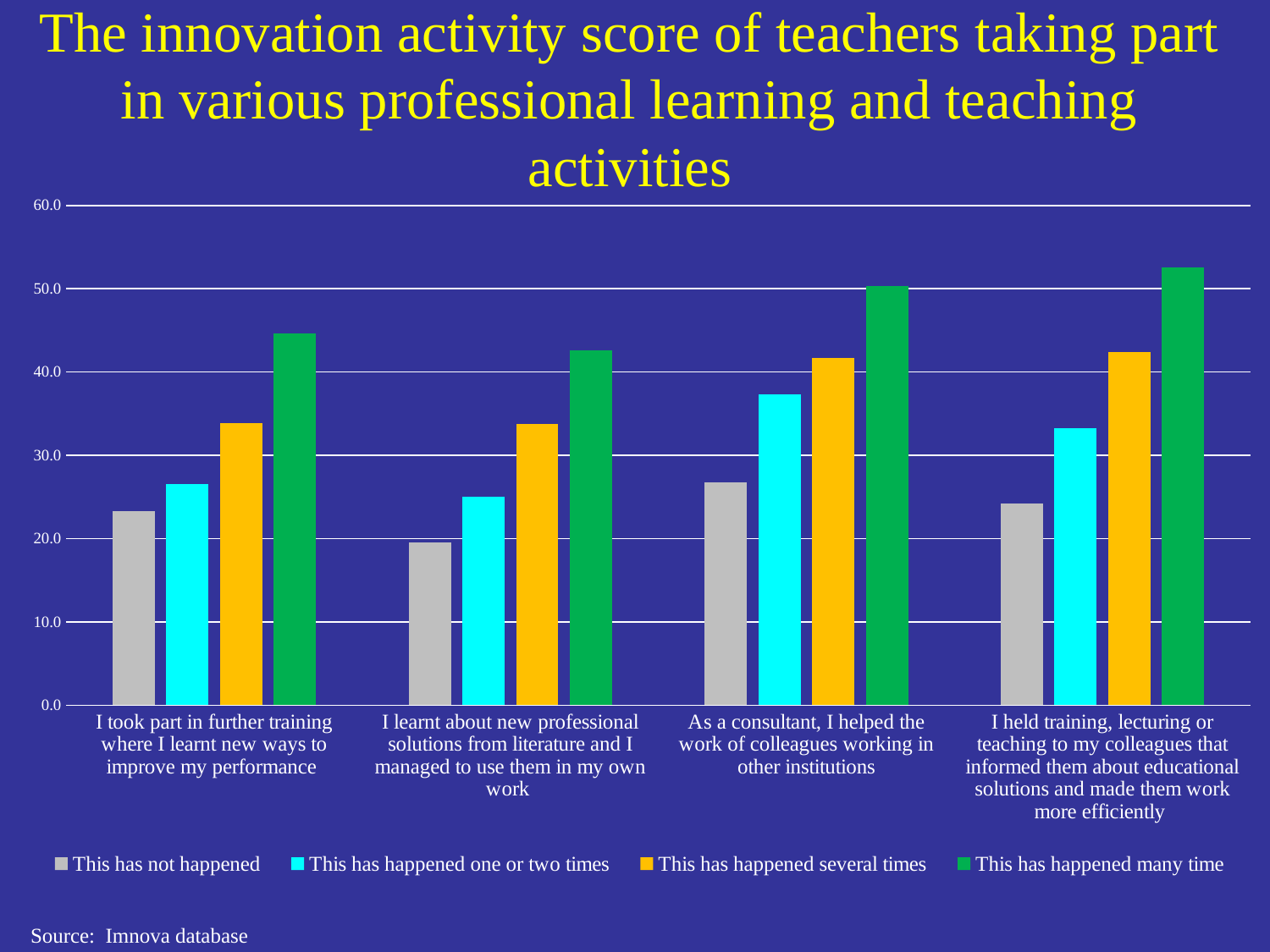
Is the 'This has happened one or two times' value for 'I learnt about new professional solutions from literature and I managed to use them in my own work' greater or less than 30? less For which activity is the 'This has happened many time' bar the highest? I held training, lecturing or teaching to my colleagues that informed them about educational solutions and made them work more efficiently How many activity categories are shown along the x axis? 4 What colour represents 'This has happened many time' in the legend? green For 'I held training, lecturing or teaching to my colleagues...', which is larger: 'This has happened several times' or 'This has happened one or two times'? This has happened several times Which activity has the larger 'This has not happened' value: 'I took part in further training...' or 'As a consultant, I helped the work of colleagues...'? As a consultant, I helped the work of colleagues working in other institutions Within each activity category, do the bars rise or fall going from 'This has not happened' to 'This has happened many time'? rise For which activity is the 'This has not happened' bar the lowest? I learnt about new professional solutions from literature and I managed to use them in my own work Is the 'This has not happened' value for 'As a consultant, I helped the work of colleagues working in other institutions' greater or less than 30? less Is the 'This has happened many time' value for 'As a consultant, I helped the work of colleagues working in other institutions' greater or less than 40? greater How many series does the legend list? 4 What kind of chart is shown on the slide? bar chart